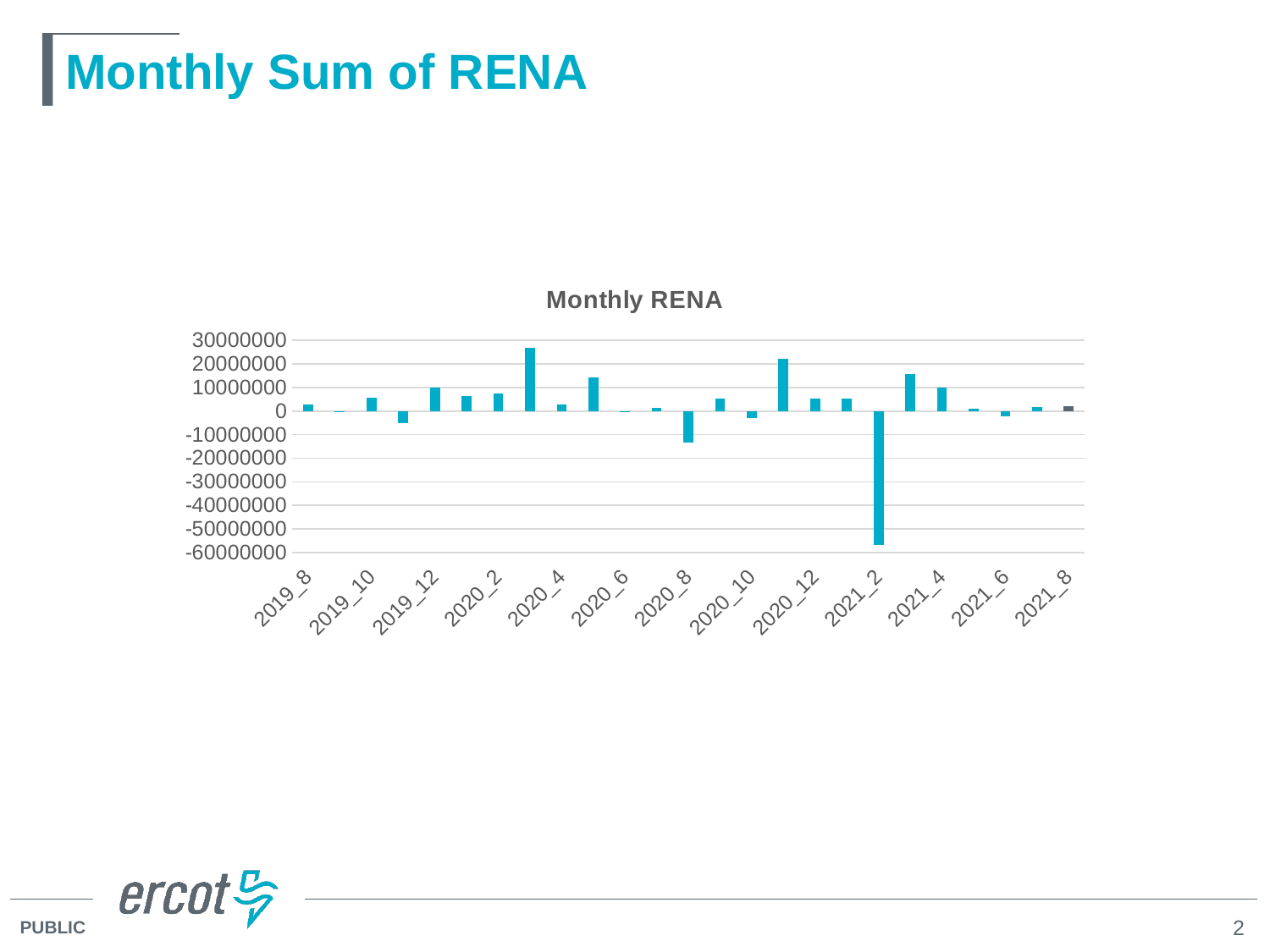
Which is larger, the value for 2020_8 or the value for 2021_2? 2020_8 Which is larger, the value for 2021_4 or the value for 2021_6? 2021_4 Is the value for 2021_4 greater or less than 0? greater What kind of chart is shown on the slide? bar chart Is the value for 2021_2 greater or less than -50000000? less How many month labels are shown on the x axis? 13 Which month has the lowest value in the Monthly RENA chart? 2021_2 Is the value for 2019_12 greater or less than 0? greater What is the title of the chart? Monthly RENA Which is larger, the value for 2019_12 or the value for 2019_10? 2019_12